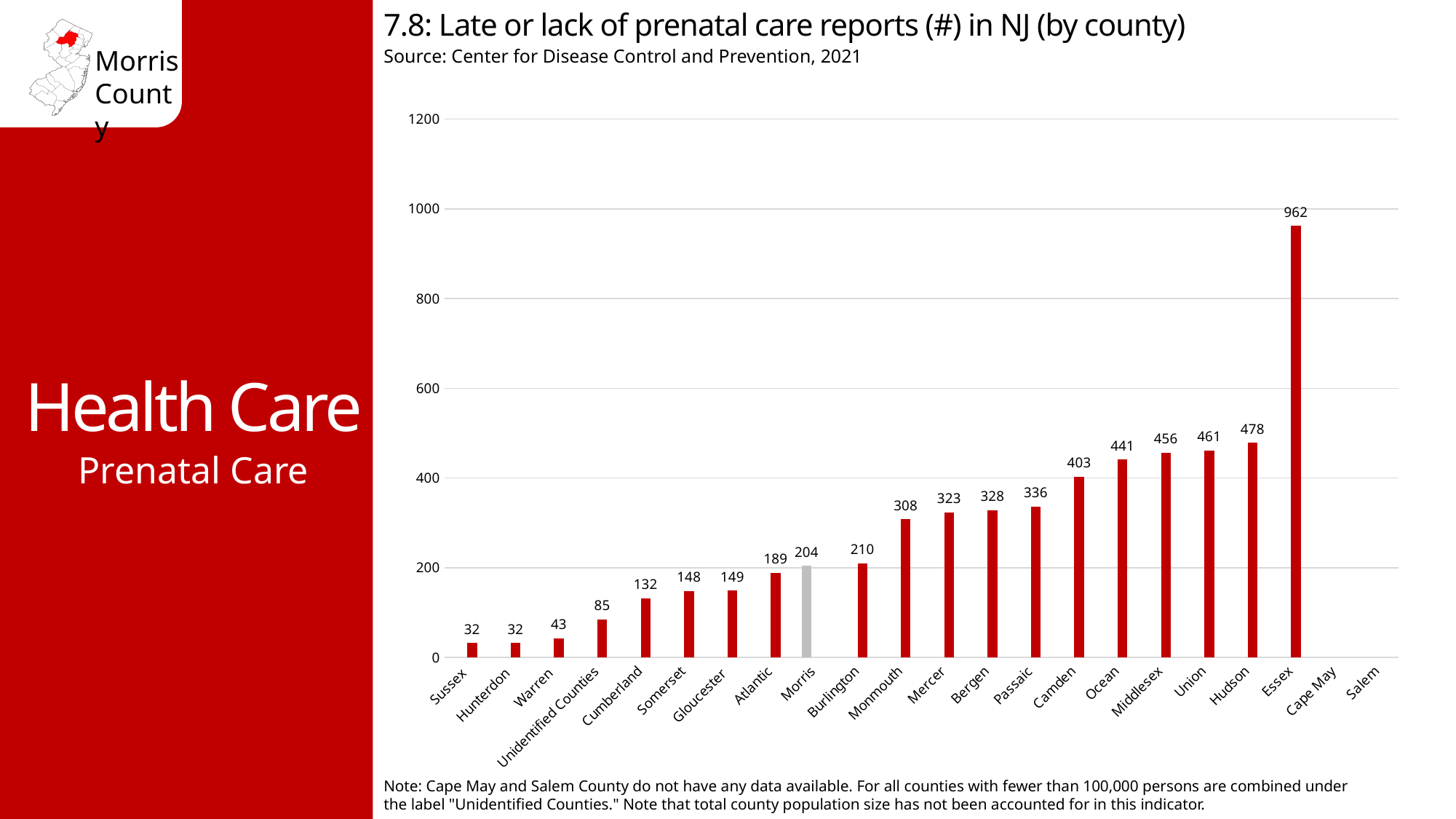
What is the value for Unidentified Counties? 85 How many counties are labelled on the x axis? 22 Which bar is coloured grey instead of red? Morris Do the values generally rise or fall from left to right along the x axis? rise What is the value for Morris? 204 Which county has the highest number of late or lack of prenatal care reports? Essex What kind of chart is shown on the slide? bar chart What is the difference between the values for Morris and Burlington? 6 What is the difference between the values for Essex and Hudson? 484 Is the value for Ocean greater or less than 400? greater What is the value for Essex? 962 Which is larger, the value for Camden or the value for Passaic? Camden